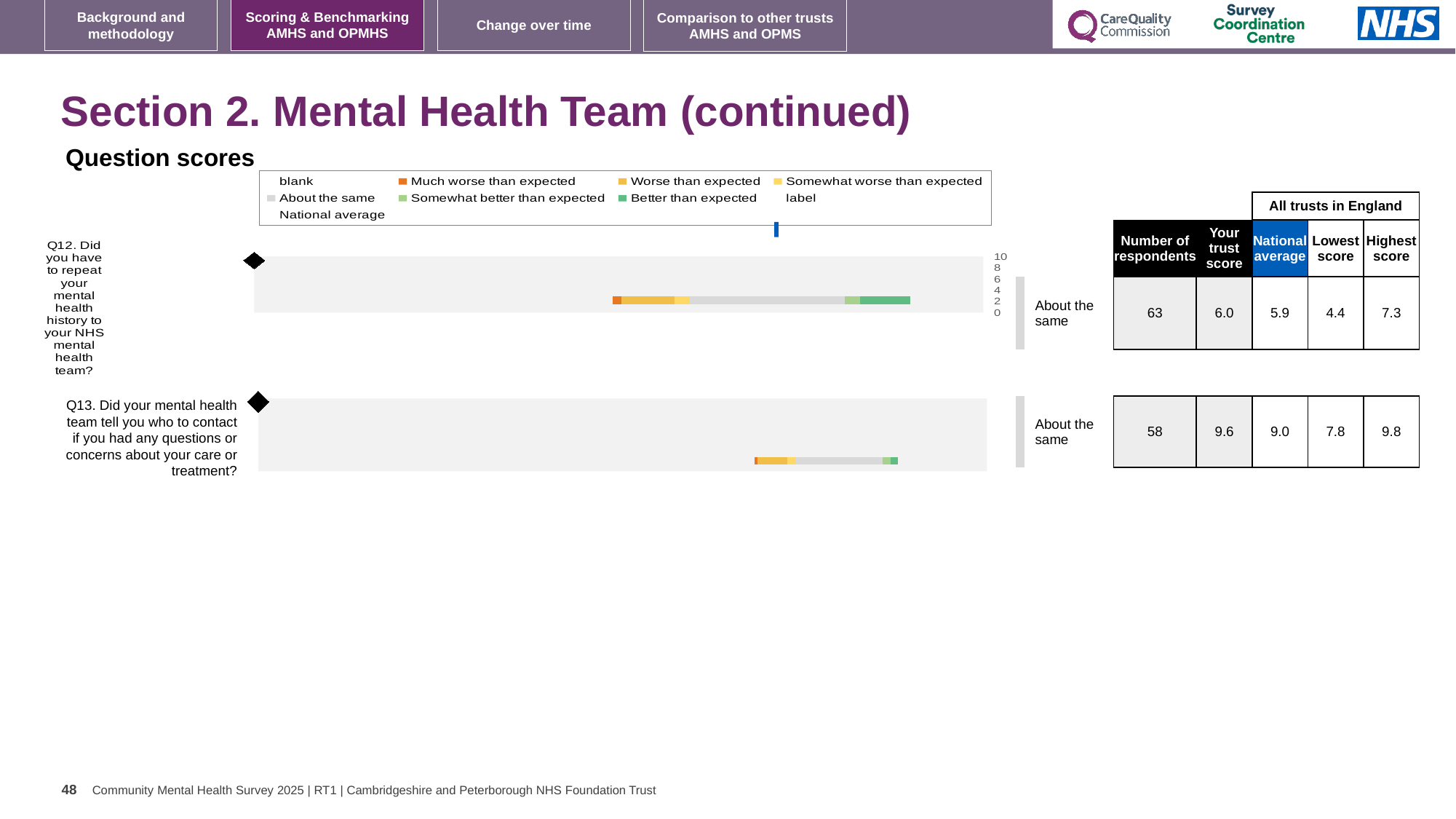
What kind of chart is used to show the question scores for Q12 and Q13? bar chart What is the highest score among all trusts in England for Q13? 9.8 What is the difference between the highest score (7.3) and the lowest score (4.4) for Q12? 2.9 In the chart legend, which colour represents 'Much worse than expected'? orange What is the difference between the trust score and the national average for Q13? 0.6 What is the national average score for Q12? 5.9 What is the number of respondents for Q13 (told who to contact with questions or concerns)? 58 What is the 'Your trust score' value for Q12 (repeating your mental health history)? 6.0 How many questions (Q12 and Q13) have a bar chart on this slide? 2 For Q13, which is larger: the trust score or the national average? the trust score What is the 'Your trust score' value for Q13? 9.6 What benchmark category is shown next to the Q12 chart? About the same